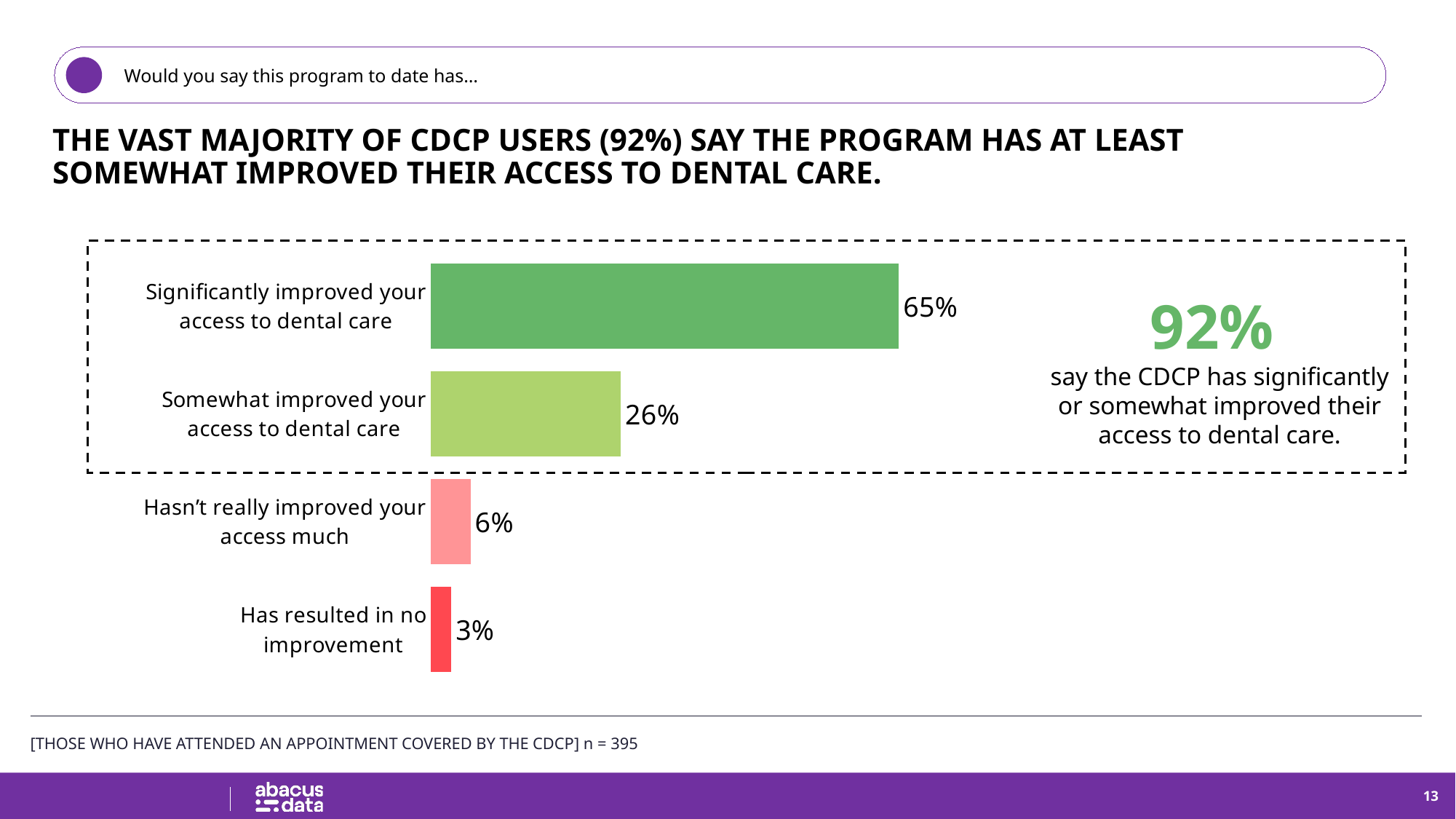
What type of chart is shown on the slide? Bar chart What percentage say the program hasn't really improved their access much? 6% What percentage say the program has somewhat improved their access to dental care? 26% What is the difference between the 'Significantly improved' and 'Somewhat improved' values? 39 percentage points Which response category has the lowest value? Has resulted in no improvement How many response categories are shown in the chart? 4 Which is larger: the value for 'Hasn't really improved your access much' or 'Has resulted in no improvement'? Hasn't really improved your access much What is the combined value of 'Hasn't really improved your access much' and 'Has resulted in no improvement'? 9% What percentage say the program has resulted in no improvement? 3% What combined percentage is highlighted in the dashed box as saying the CDCP significantly or somewhat improved their access? 92% What percentage of CDCP users say the program has significantly improved their access to dental care? 65% Which response category has the highest value? Significantly improved your access to dental care